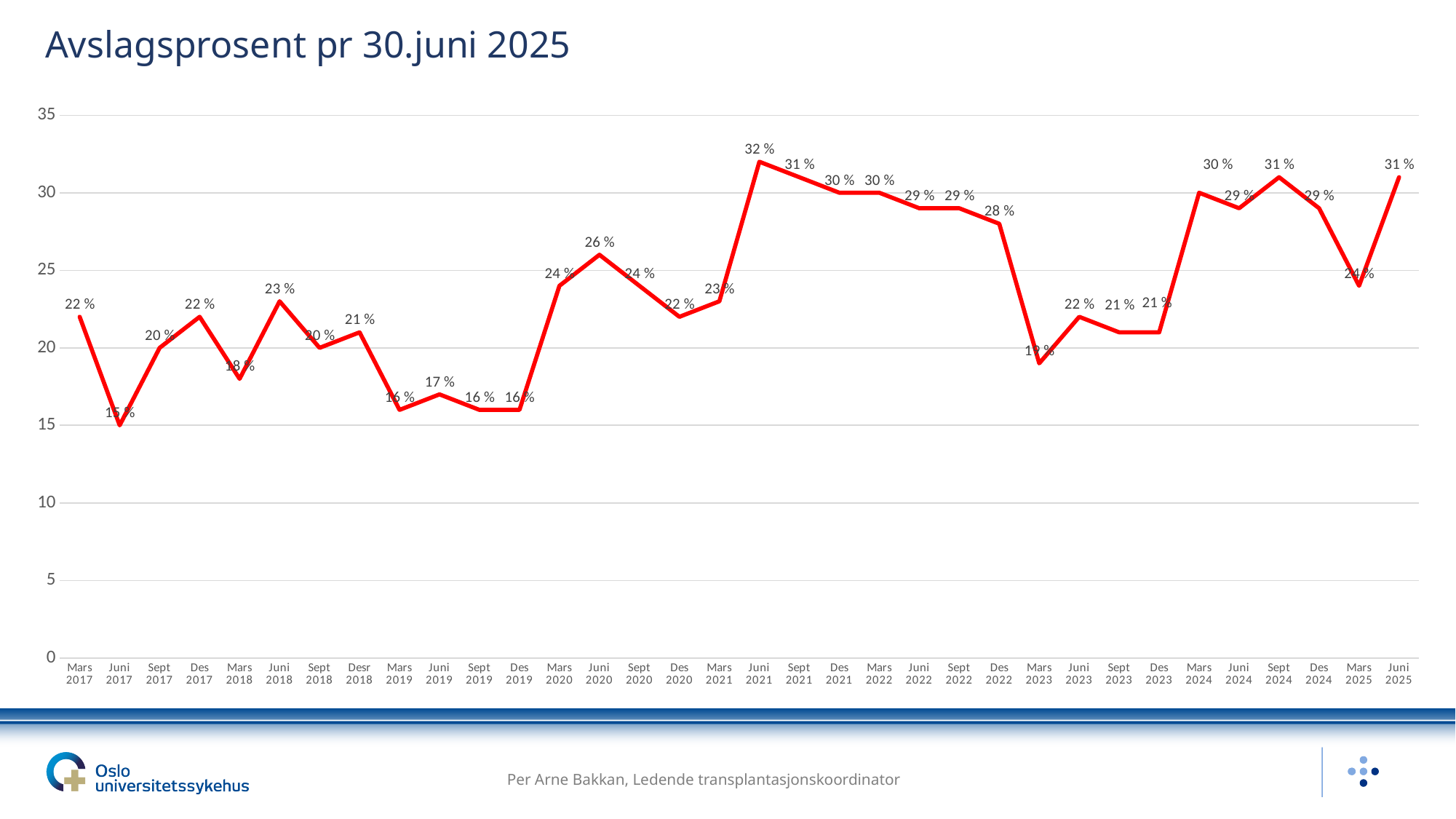
Do the values rise or fall from Juni 2021 to Des 2022? fall What is the difference between the values for Juni 2025 and Mars 2025? 7 % Which period has the lowest value? Juni 2017 Which period has the highest value? Juni 2021 What is the value for Juni 2025? 31 % What kind of chart is shown on the slide? line chart Is the value for Des 2022 greater or less than 25? greater What is the value for Juni 2020? 26 % What is the difference between the values for Juni 2021 and Juni 2017? 17 % What is the value for Mars 2017? 22 % How many data points are plotted on the chart? 34 Which is larger, the value for Mars 2023 or the value for Juni 2023? Juni 2023